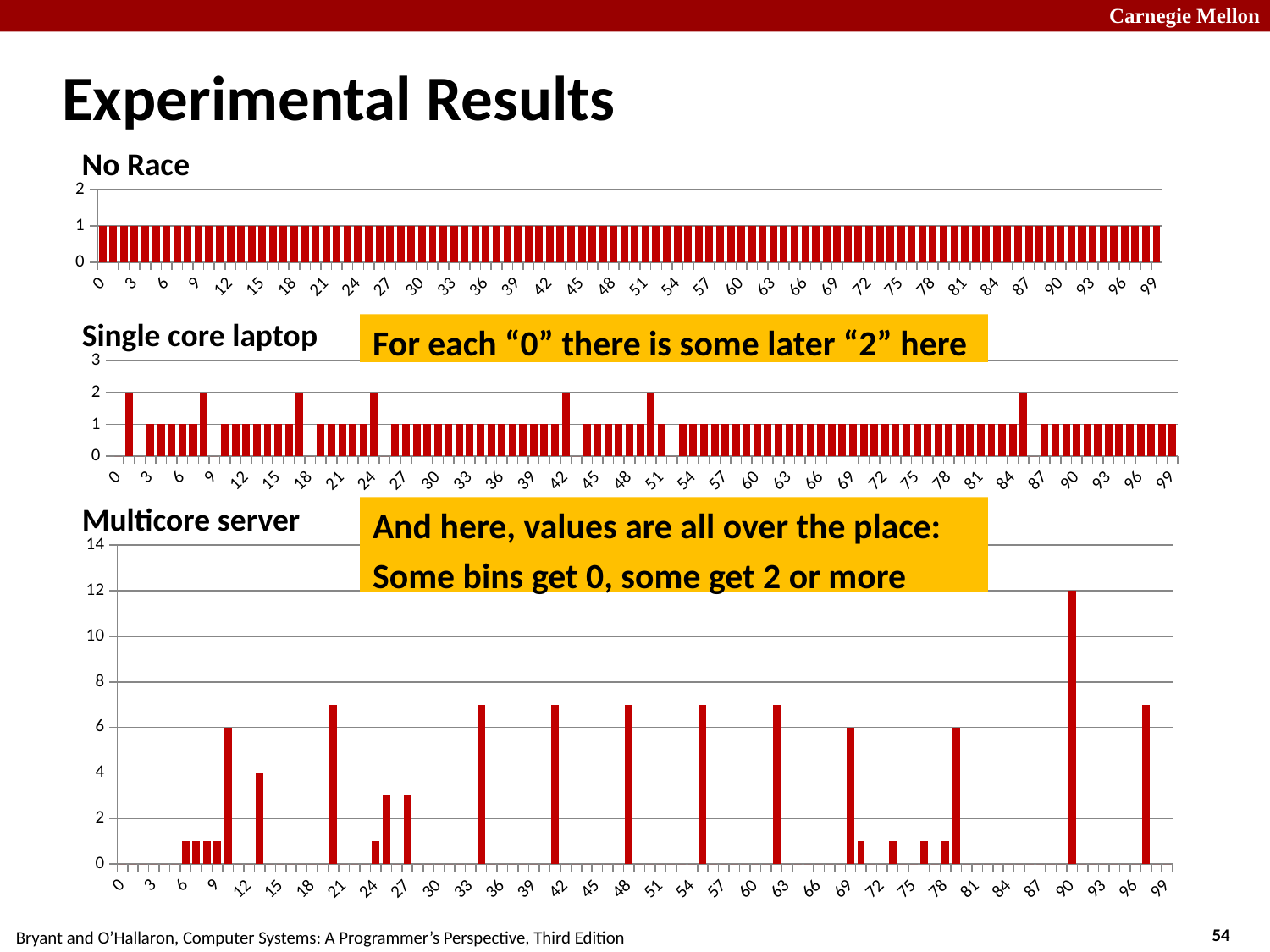
In the "Multicore server" chart, which bin has the tallest bar? 90 In the "Single core laptop" chart, what is the highest value any bar reaches? 2 In the "Multicore server" chart, what is the highest value shown on the y axis? 14 What kind of chart is the "No Race" chart at the top of the slide? bar chart In the "Single core laptop" chart, what is the highest value shown on the y axis? 3 In the "Multicore server" chart, what value does the tallest bar reach? 12 In the "No Race" chart, what value does every bar reach? 1 In the "No Race" chart, what is the highest value shown on the y axis? 2 In the "Multicore server" chart, is the value for bin 10 greater or less than 8? less In the "Multicore server" chart, is the value for bin 90 greater or less than 10? greater In the "Multicore server" chart, which is larger, the value for bin 90 or the value for bin 97? bin 90 How many charts are shown on the slide? 3